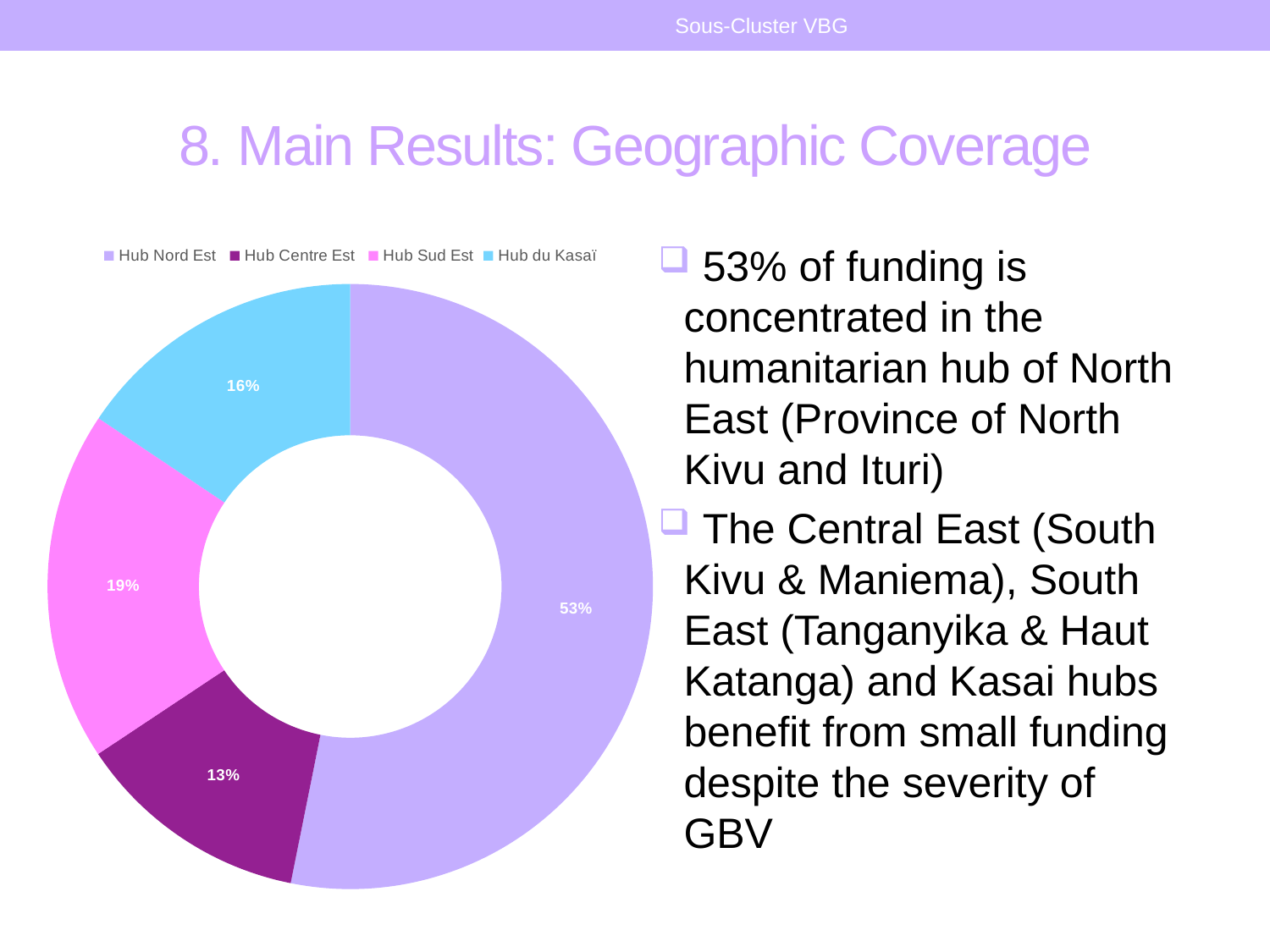
How many hubs are shown in the chart? 4 What share of funding goes to Hub du Kasaï? 16% Which hub has the largest share of funding? Hub Nord Est What is the difference in percentage points between Hub Nord Est and Hub Sud Est? 34 What colour represents Hub du Kasaï in the chart? Light blue What kind of chart is shown on the slide? Doughnut chart What share of funding goes to Hub Sud Est? 19% What share of funding goes to Hub Nord Est? 53% Which has a larger share, Hub du Kasaï or Hub Centre Est? Hub du Kasaï What is the difference in percentage points between Hub Sud Est and Hub du Kasaï? 3 What share of funding goes to Hub Centre Est? 13% Which hub has the smallest share of funding? Hub Centre Est